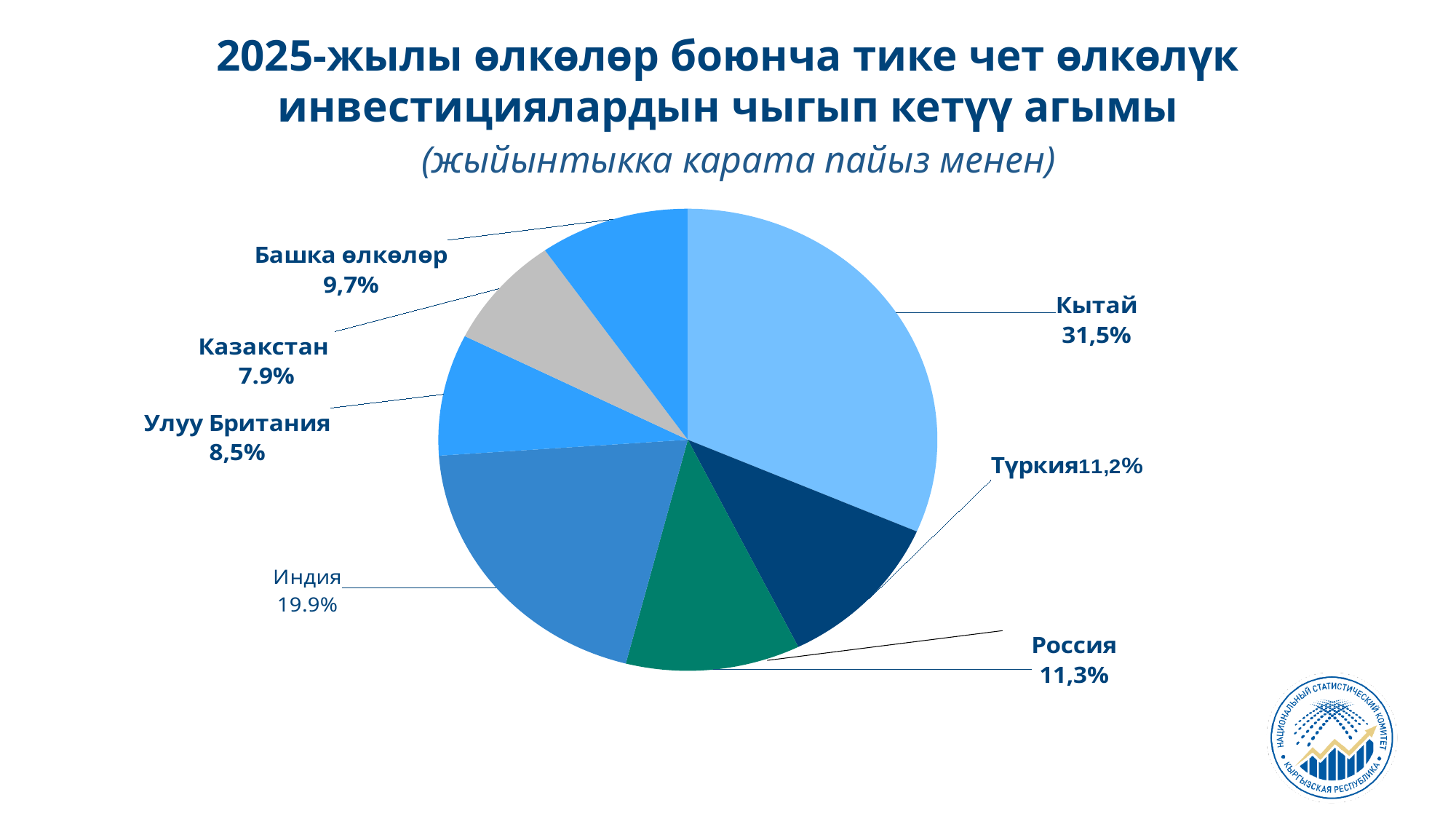
What is the value shown for Түркия? 11,2% Which category has the largest slice of the pie? Кытай What is the value shown for Башка өлкөлөр? 9,7% What kind of chart is shown on the slide? pie chart Which category has the smallest slice of the pie? Казакстан What is the value shown for Индия? 19.9% What is the value shown for Россия? 11,3% What is the value shown for Улуу Британия? 8,5% What share of the pie does Кытай hold? 31,5% What is the value shown for Казакстан? 7.9% How many slices does the pie chart have? 7 Which is larger, the slice for Индия or the slice for Россия? Индия